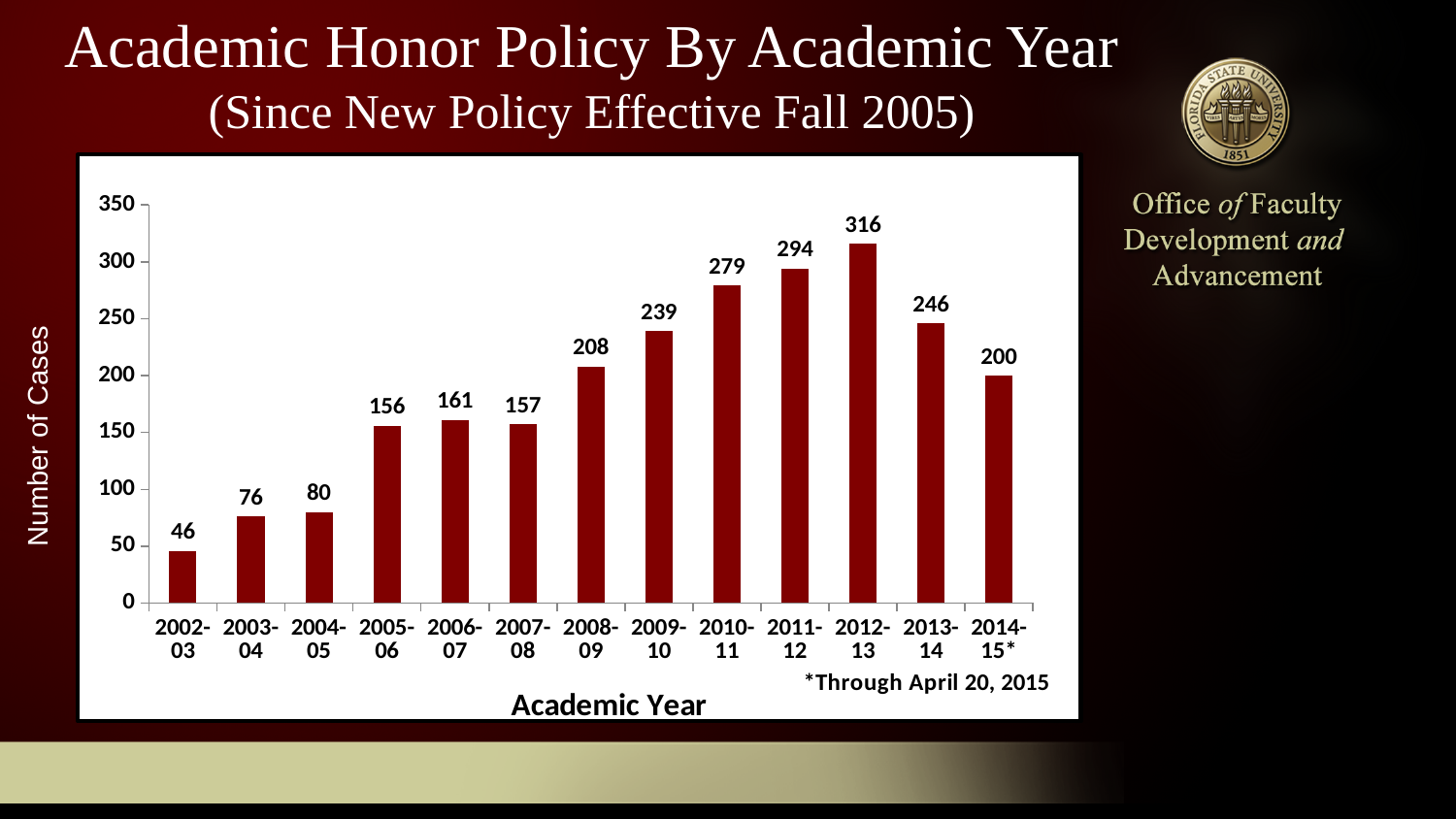
Which academic year has the highest number of cases? 2012-13 What kind of chart is shown on the slide? Bar chart How many cases were there in the 2002-03 academic year? 46 What is the number of cases for 2012-13? 316 Which academic year has the lowest number of cases? 2002-03 Is the value for 2009-10 greater or less than 200? greater What is the label of the y axis? Number of Cases What is the difference in the number of cases between 2005-06 and 2004-05? 76 What is the number of cases shown for 2014-15*? 200 What is the difference in the number of cases between 2012-13 and 2013-14? 70 How many academic years are shown on the x axis? 13 Which year had more cases, 2006-07 or 2007-08? 2006-07